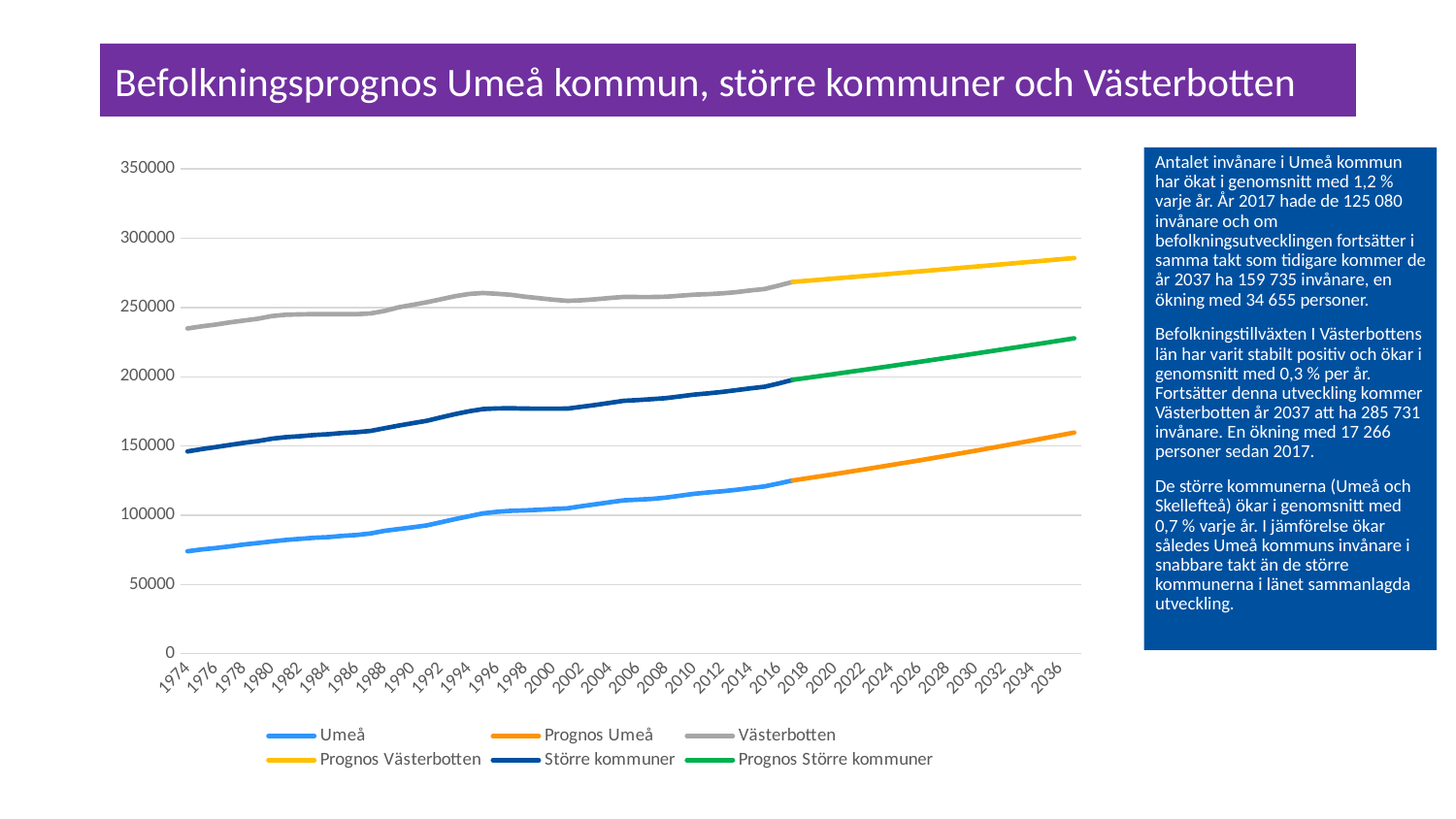
In 2000, which series has the larger value, Västerbotten or Umeå? Västerbotten Does the Umeå series rise or fall from 1974 to 2016? rise Is the value for Umeå in 1974 greater or less than 100000? less Is the value for Västerbotten in 1974 greater or less than 200000? greater What is the title of the slide's chart area? Befolkningsprognos Umeå kommun, större kommuner och Västerbotten Is the value for Prognos Umeå in 2036 greater or less than 150000? greater Which colour is used for the Prognos Umeå series in the legend? orange What kind of chart is shown on the slide? line chart How many series does the legend list? 6